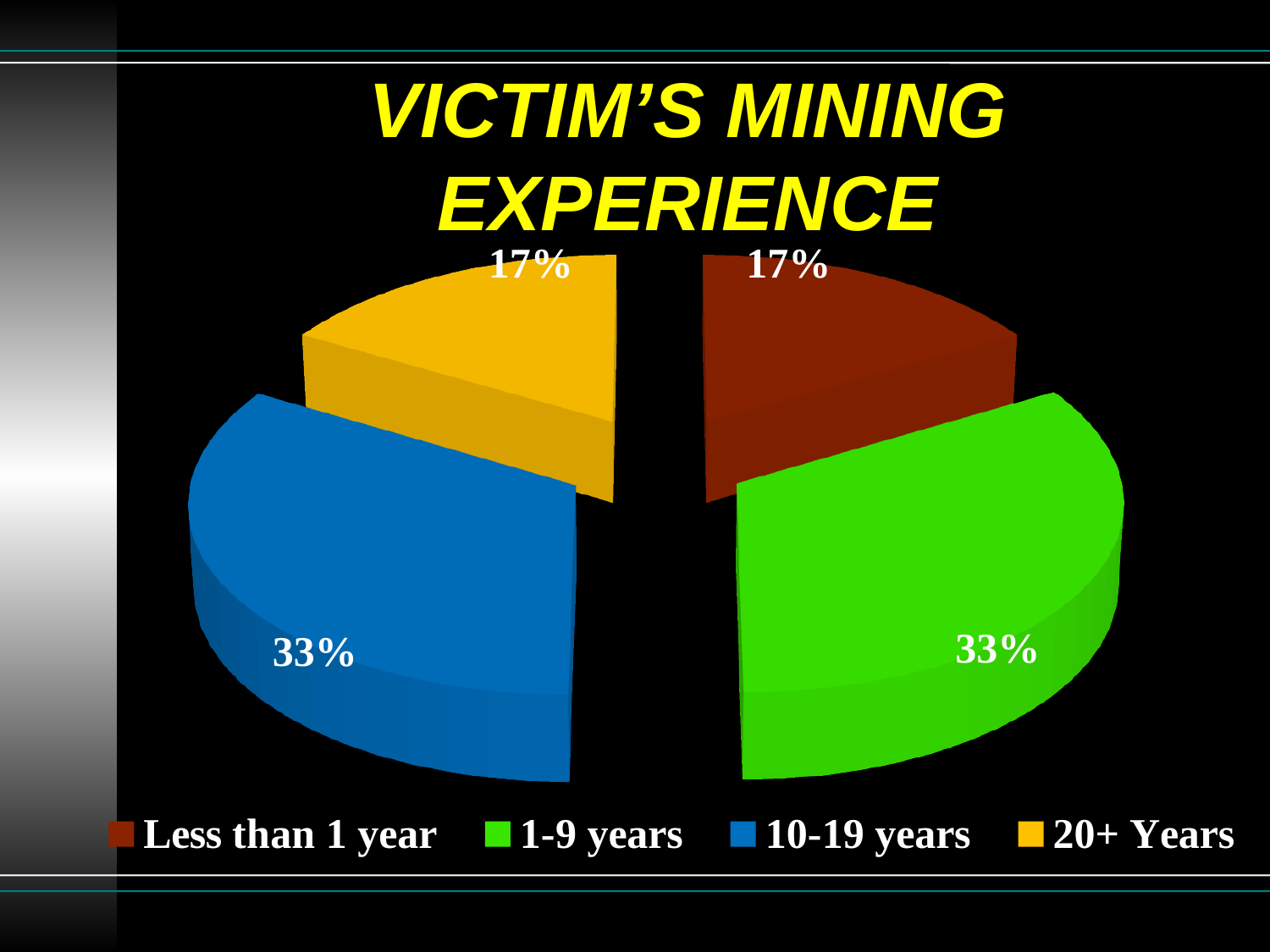
What is the difference in percentage points between the 10-19 years slice and the Less than 1 year slice? 16 percentage points Which is larger, the 1-9 years slice or the 20+ Years slice? 1-9 years Which is larger, the Less than 1 year slice or the 10-19 years slice? 10-19 years How many slices does the pie chart have? 4 Which category is shown in blue in the legend? 10-19 years What share of the pie does the 1-9 years slice represent? 33% What is the value shown for the 20+ Years slice? 17% What is the value shown for the 10-19 years slice? 33% Do the 1-9 years and 10-19 years slices have the same value? Yes What share of the pie does the Less than 1 year slice represent? 17% What kind of chart is shown on the slide? Pie chart What is the title of the chart? VICTIM'S MINING EXPERIENCE